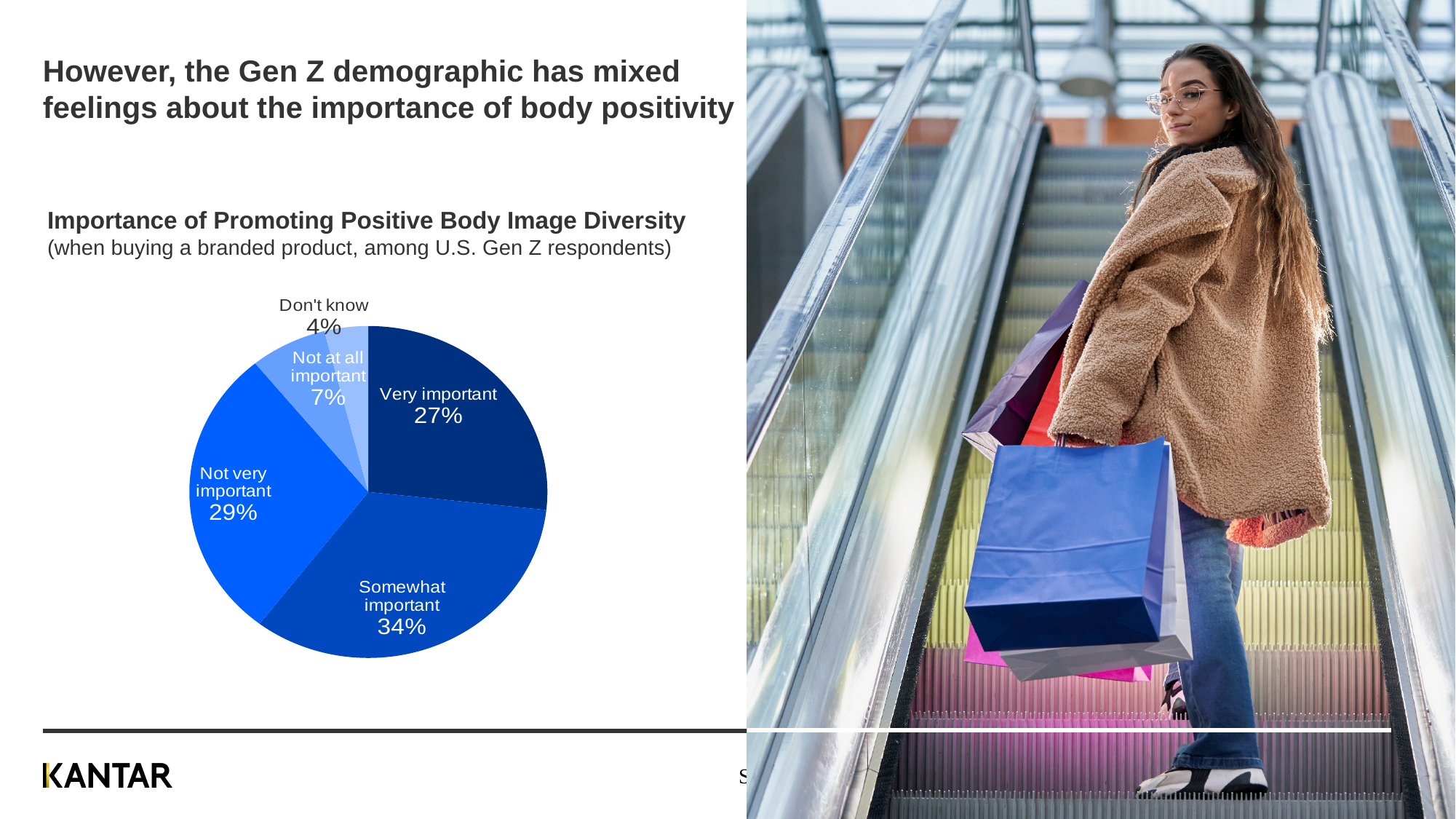
What share of respondents said "Somewhat important"? 34% What kind of chart is shown on the slide? Pie chart Which is larger: the share for "Not very important" or the share for "Very important"? Not very important What is the title of the chart? Importance of Promoting Positive Body Image Diversity What share of respondents said promoting positive body image diversity is "Very important"? 27% Which response category has the largest share of the pie? Somewhat important What share of respondents said "Not at all important"? 7% What is the difference in percentage points between "Somewhat important" and "Very important"? 7 percentage points How many categories are shown in the pie chart? 5 Which response category has the smallest share of the pie? Don't know What share of respondents said "Not very important"? 29% What share of respondents answered "Don't know"? 4%